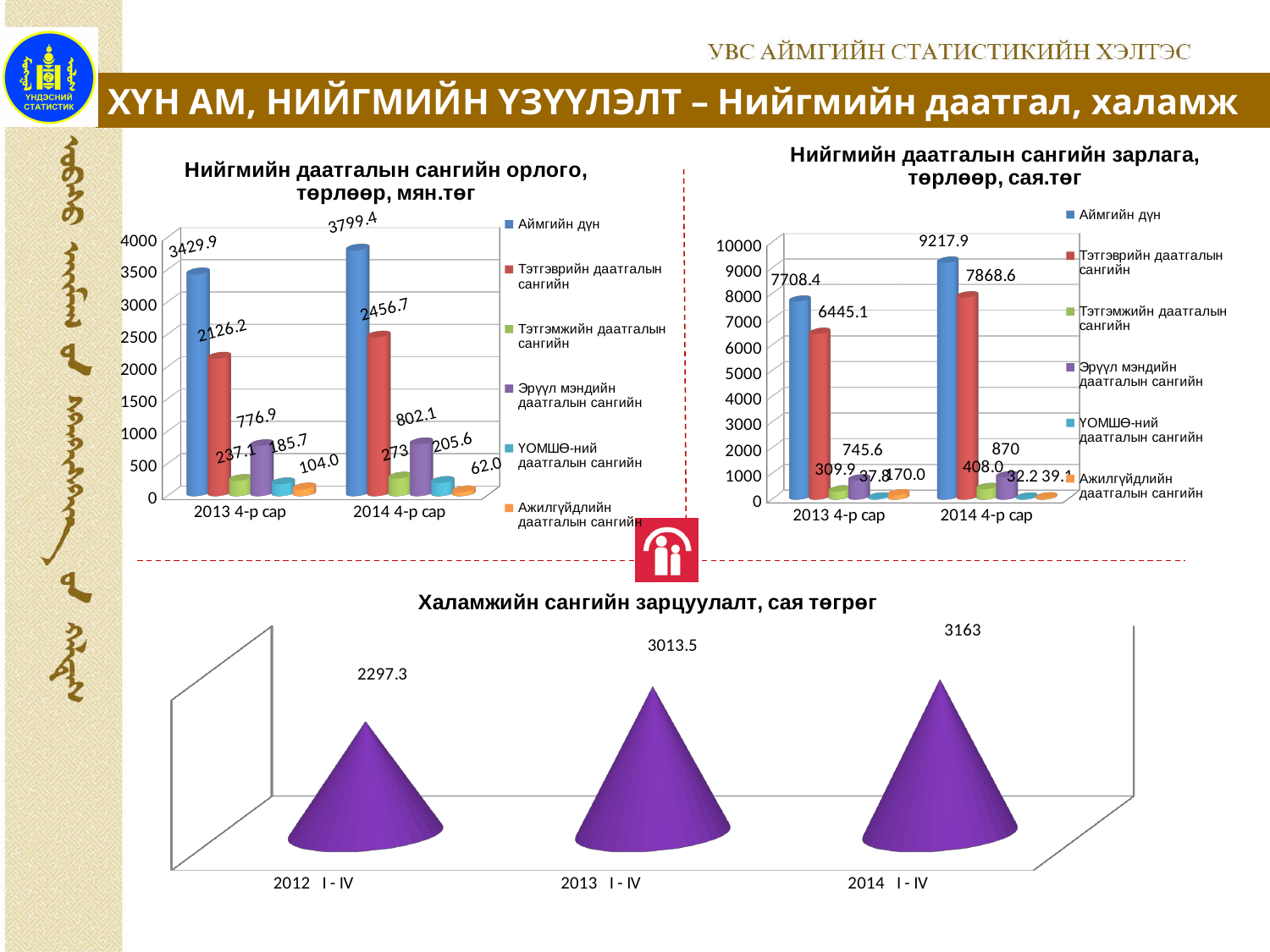
In the chart 'Нийгмийн даатгалын сангийн орлого, төрлөөр, мян.төг', what is the value of Аймгийн дүн for 2014 4-р сар? 3799.4 In the chart 'Нийгмийн даатгалын сангийн орлого, төрлөөр, мян.төг', how many series does the legend list? 6 In the chart 'Халамжийн сангийн зарцуулалт, сая төгрөг', what is the value for 2013 I - IV? 3013.5 In the chart 'Нийгмийн даатгалын сангийн зарлага, төрлөөр, сая.төг', which series has the lowest value for 2014 4-р сар? ҮОМШӨ-ний даатгалын сангийн In the chart 'Халамжийн сангийн зарцуулалт, сая төгрөг', do the values rise or fall from 2012 I - IV to 2014 I - IV? rise In the chart 'Нийгмийн даатгалын сангийн орлого, төрлөөр, мян.төг', what is the difference between Аймгийн дүн for 2014 4-р сар and 2013 4-р сар? 369.5 In the chart 'Халамжийн сангийн зарцуулалт, сая төгрөг', which period has the highest value? 2014 I - IV In the chart 'Нийгмийн даатгалын сангийн орлого, төрлөөр, мян.төг', which is larger for Ажилгүйдлийн даатгалын сангийн: 2013 4-р сар or 2014 4-р сар? 2013 4-р сар In the chart 'Нийгмийн даатгалын сангийн зарлага, төрлөөр, сая.төг', what is the difference between Тэтгэврийн даатгалын сангийн for 2014 4-р сар and 2013 4-р сар? 1423.5 In the chart 'Нийгмийн даатгалын сангийн зарлага, төрлөөр, сая.төг', what is the value of Аймгийн дүн for 2014 4-р сар? 9217.9 In the chart 'Нийгмийн даатгалын сангийн зарлага, төрлөөр, сая.төг', what is the value of Эрүүл мэндийн даатгалын сангийн for 2013 4-р сар? 745.6 In the chart 'Нийгмийн даатгалын сангийн орлого, төрлөөр, мян.төг', what is the value of Тэтгэврийн даатгалын сангийн for 2013 4-р сар? 2126.2